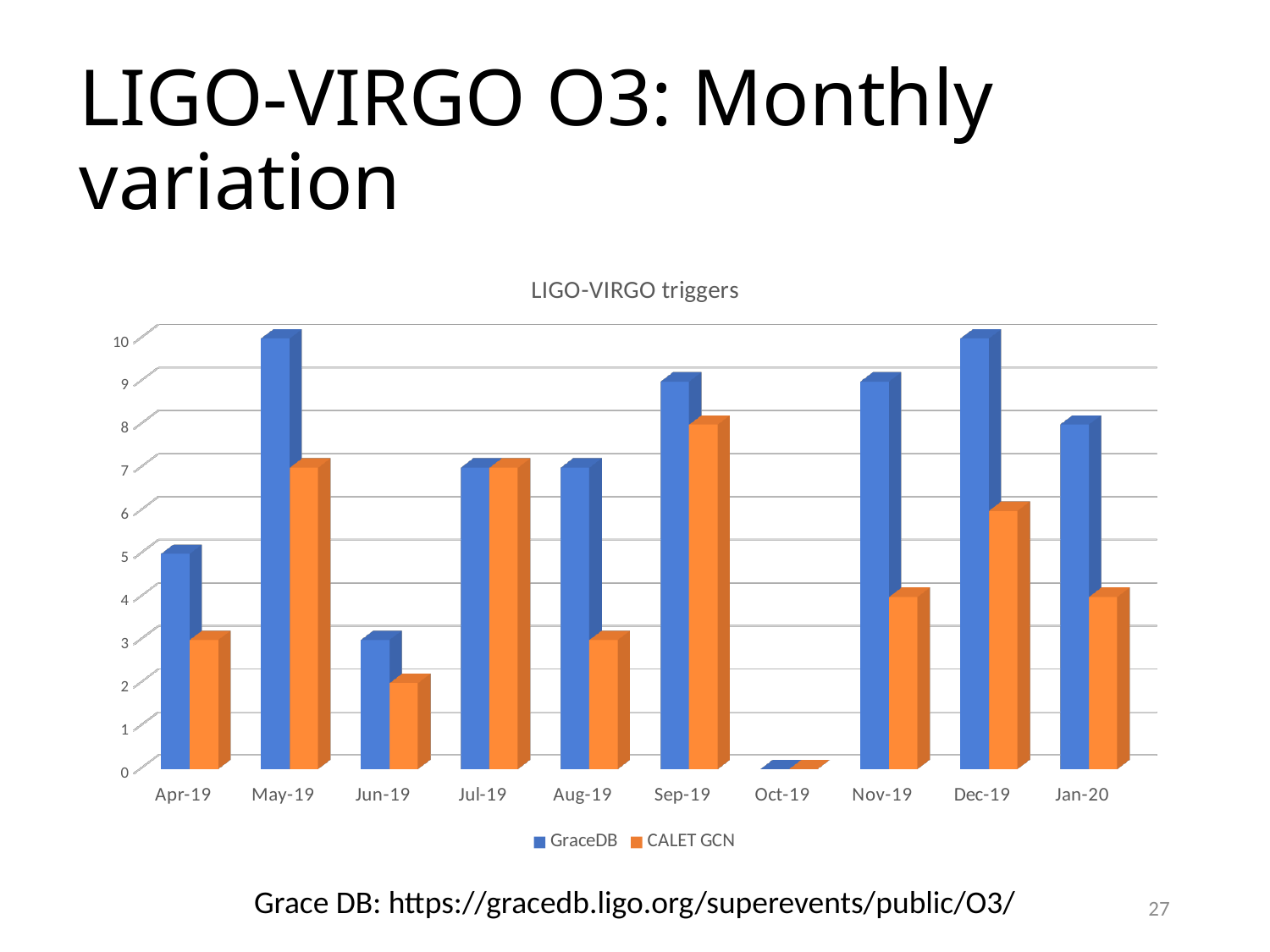
What kind of chart is shown on the slide? Bar chart Is the GraceDB value for May-19 greater or less than 8? greater For Dec-19, which series has the larger value, GraceDB or CALET GCN? GraceDB Is the GraceDB value for Jun-19 greater or less than 5? less What is the title of the chart? LIGO-VIRGO triggers For Apr-19, which series has the larger value, GraceDB or CALET GCN? GraceDB Which month has the lowest GraceDB value? Oct-19 Is the CALET GCN value for Nov-19 greater or less than 6? less Which month has the highest CALET GCN value? Sep-19 How many series does the legend list? 2 Which colour represents the CALET GCN series? Orange How many months are shown on the x axis? 10